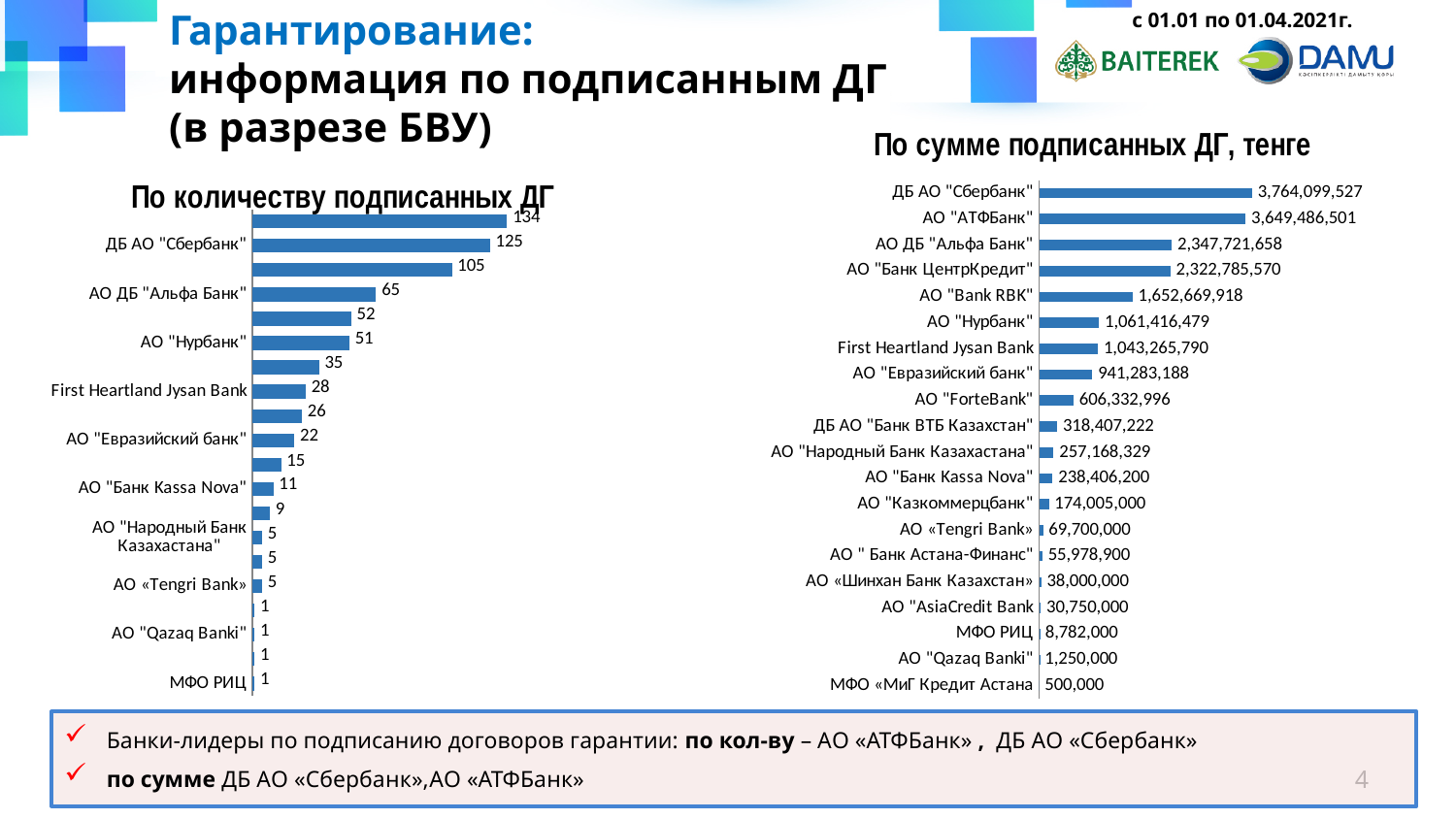
In the chart "По количеству подписанных ДГ", what is the difference between ДБ АО "Сбербанк" and АО ДБ "Альфа Банк"? 60 In the chart "По количеству подписанных ДГ", what is the value for АО ДБ "Альфа Банк"? 65 What type of chart is "По количеству подписанных ДГ"? Bar chart How many categories are shown in the chart "По сумме подписанных ДГ, тенге"? 20 In the chart "По количеству подписанных ДГ", what is the value for АО "Нурбанк"? 51 In the chart "По сумме подписанных ДГ, тенге", which is larger: АО "Нурбанк" or First Heartland Jysan Bank? АО "Нурбанк" In the chart "По сумме подписанных ДГ, тенге", which bank has the highest value? ДБ АО "Сбербанк" In the chart "По сумме подписанных ДГ, тенге", what is the value for ДБ АО "Сбербанк"? 3,764,099,527 In the chart "По сумме подписанных ДГ, тенге", what is the value for АО "ForteBank"? 606,332,996 In the chart "По количеству подписанных ДГ", what is the value for First Heartland Jysan Bank? 28 In the chart "По сумме подписанных ДГ, тенге", what is the difference between ДБ АО "Сбербанк" and АО "АТФБанк"? 114,613,026 In the chart "По сумме подписанных ДГ, тенге", which category has the lowest value? МФО «МиГ Кредит Астана»